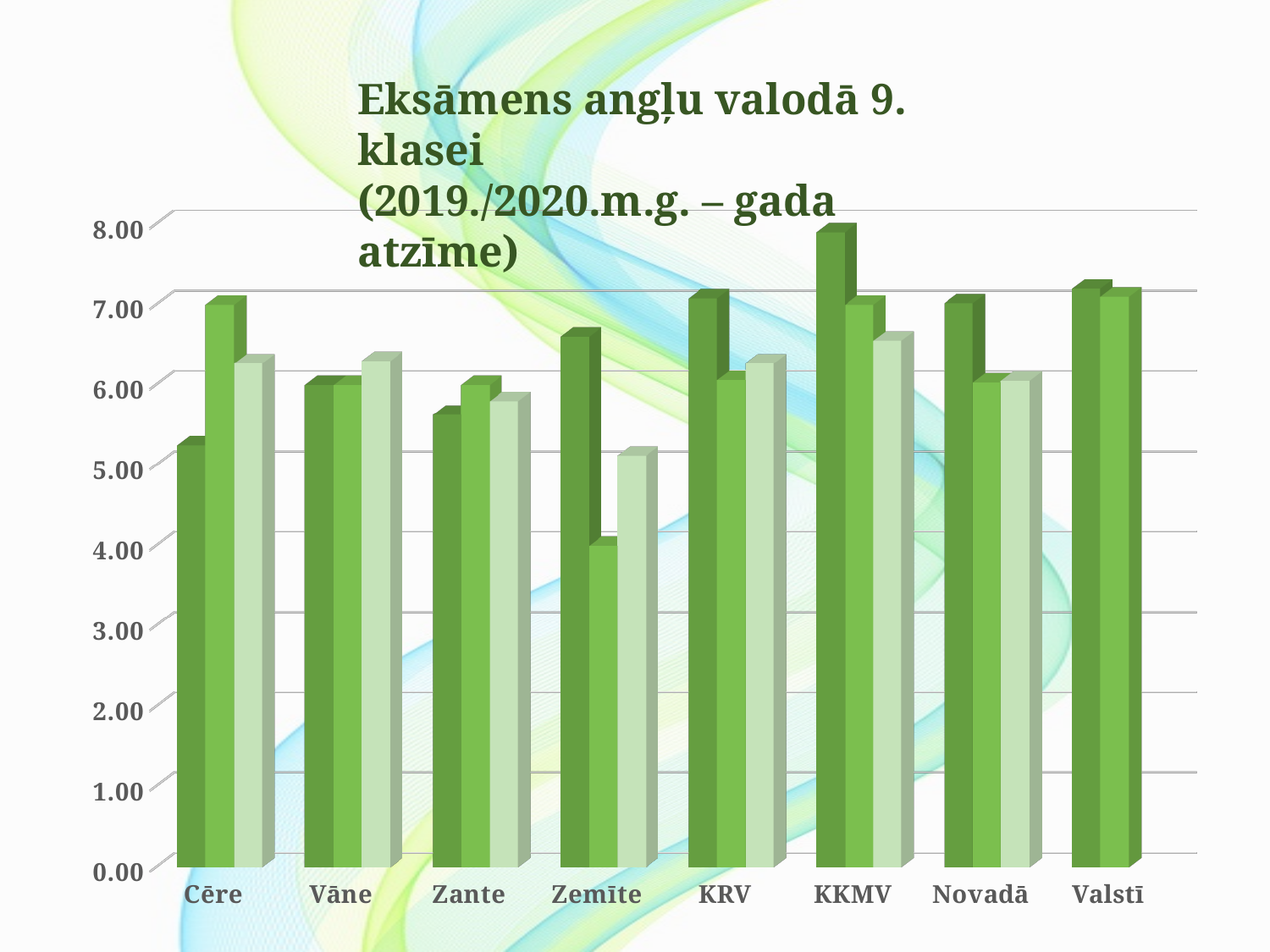
Which category contains the shortest bar in the chart? Zemīte Is the value of the darkest green bar for Cēre greater or less than 6.00? less Is the value of the darkest green bar for KKMV greater or less than 7.00? greater Is the value of the darkest green bar for Zante greater or less than 6.00? less Which category contains the tallest bar in the chart? KKMV What kind of chart is shown on the slide? bar chart For Zemīte, which is larger: the darkest green bar or the medium green bar? the darkest green bar What is the title of the chart? Eksāmens angļu valodā 9. klasei (2019./2020.m.g. – gada atzīme) How many categories are shown along the x axis? 8 For Cēre, which is larger: the darkest green bar or the medium green bar? the medium green bar